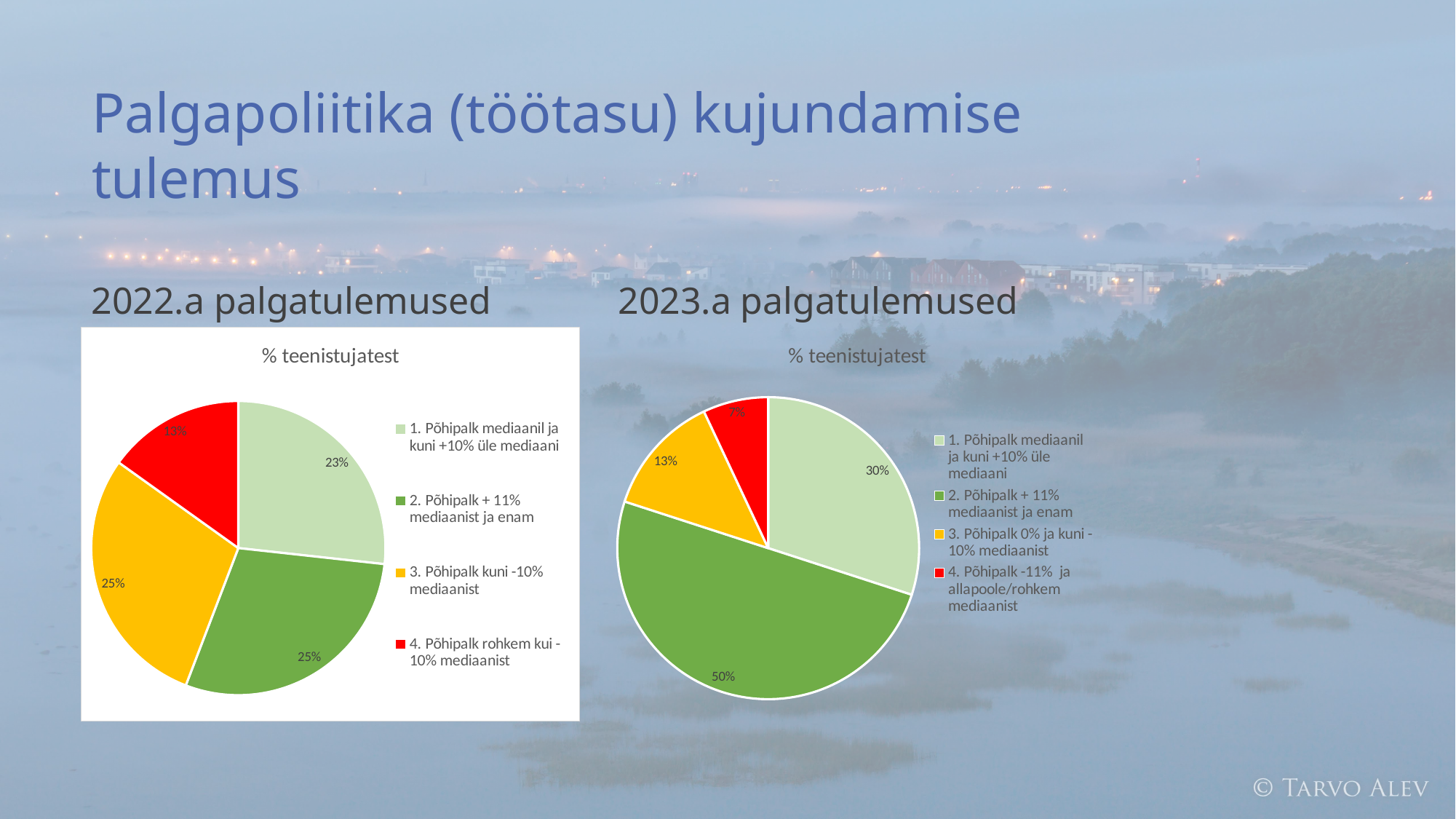
In the 2023.a palgatulemused chart, what share is shown for '4. Põhipalk -11% ja allapoole/rohkem mediaanist'? 7% In the 2022.a palgatulemused chart, what share of employees falls in category '1. Põhipalk mediaanil ja kuni +10% üle mediaani'? 23% In the 2023.a palgatulemused chart, what share is shown for '2. Põhipalk + 11% mediaanist ja enam'? 50% Which is larger: the share for category 1 in the 2022.a palgatulemused chart or in the 2023.a palgatulemused chart? 2023.a palgatulemused (30%) What type of chart is used for the 2022.a palgatulemused data? pie chart In the 2023.a palgatulemused chart, which category has the smallest slice? 4. Põhipalk -11% ja allapoole/rohkem mediaanist In the 2022.a palgatulemused chart, what share is shown for '4. Põhipalk rohkem kui -10% mediaanist'? 13% In the 2023.a palgatulemused chart, which category has the largest slice? 2. Põhipalk + 11% mediaanist ja enam In the 2022.a palgatulemused chart, which category has the smallest slice? 4. Põhipalk rohkem kui -10% mediaanist How many categories does the legend of the 2022.a palgatulemused chart list? 4 In the 2023.a palgatulemused chart, what is the difference between the share for category 2 (50%) and category 1 (30%)? 20% What colour is used for category '3. Põhipalk kuni -10% mediaanist' in the 2022.a palgatulemused chart? yellow